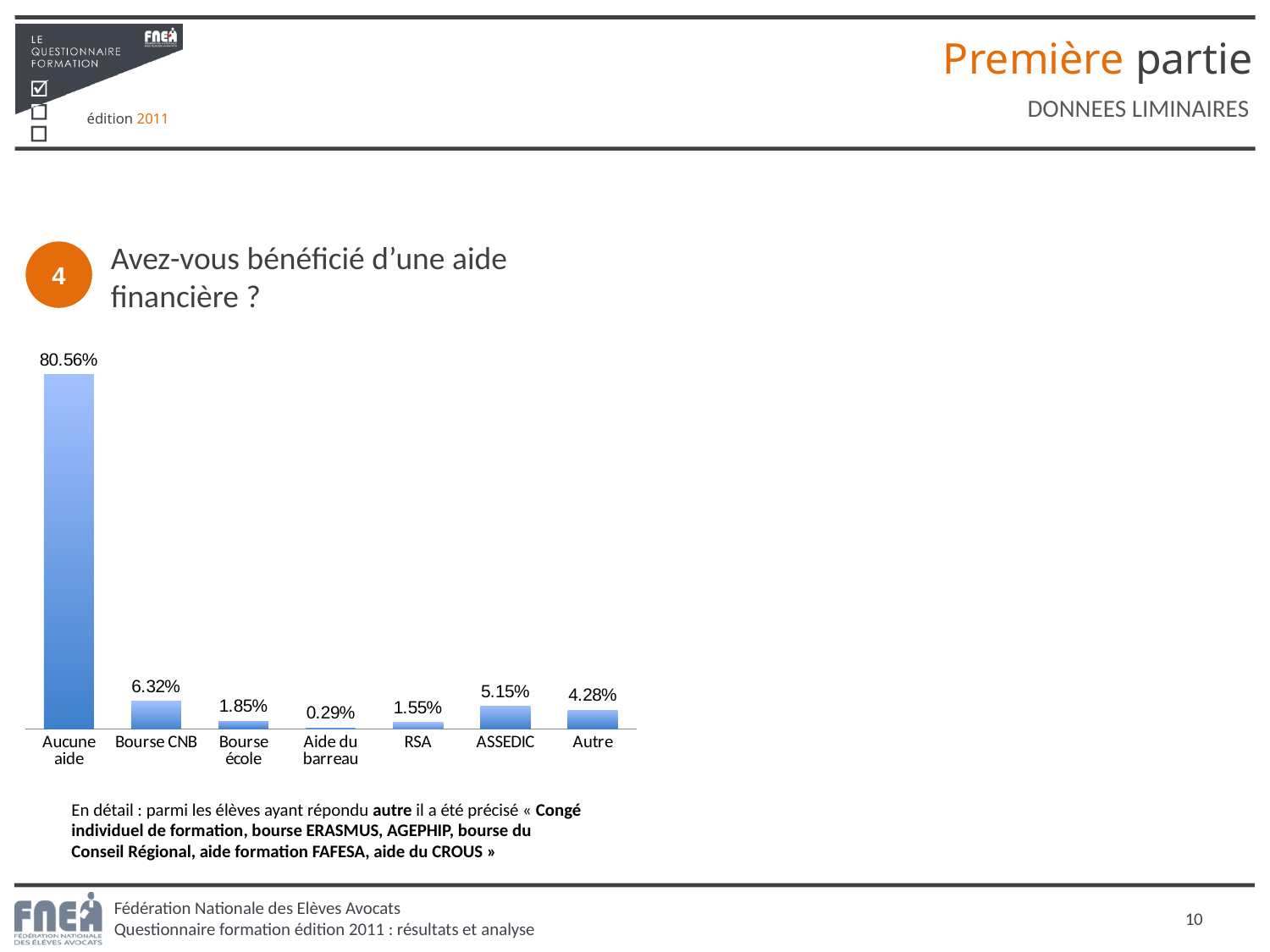
What is the value for Aucune aide? 80.56% What is the value for ASSEDIC? 5.15% How many categories are shown on the x axis? 7 What kind of chart is shown on the slide? Bar chart What is the difference between the values for RSA and Aide du barreau? 1.26% Which category has the lowest value? Aide du barreau What is the value for Aide du barreau? 0.29% What is the difference between the values for Bourse CNB and ASSEDIC? 1.17% Which category has the highest value? Aucune aide What question does the chart on the slide answer? Avez-vous bénéficié d'une aide financière ? Which is larger, the value for Autre or the value for Bourse école? Autre What is the value for Bourse CNB? 6.32%